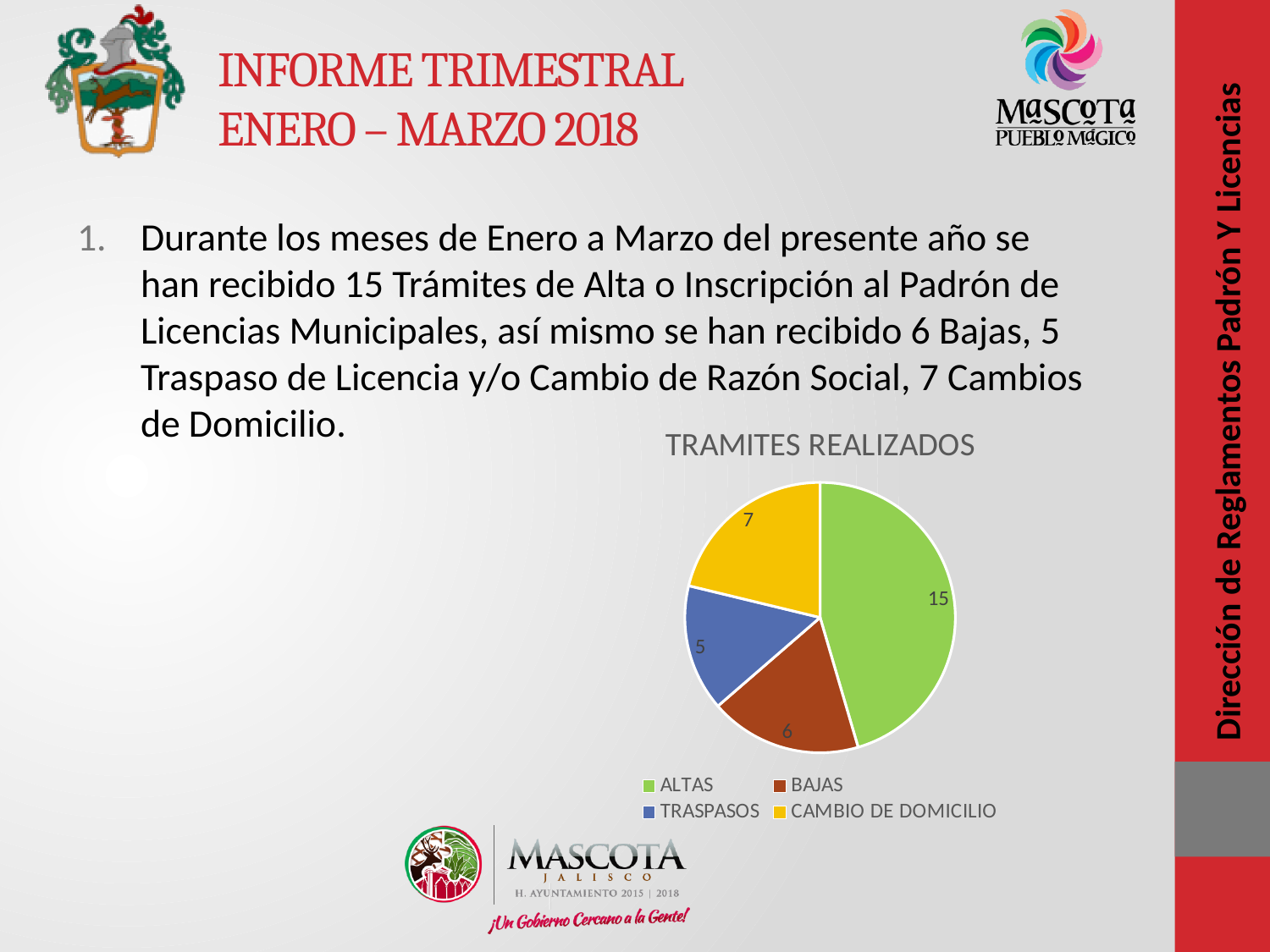
Which category has the smallest slice in the pie chart? TRASPASOS What is the value for TRASPASOS in the pie chart? 5 What is the value for CAMBIO DE DOMICILIO in the pie chart? 7 Which category has the largest slice in the pie chart? ALTAS What is the title of the chart? TRAMITES REALIZADOS What is the value for ALTAS in the pie chart? 15 What is the value for BAJAS in the pie chart? 6 How many categories does the pie chart show? 4 What is the difference between the values for ALTAS and BAJAS? 9 What type of chart is shown on the slide? pie chart What is the total of all slices in the pie chart? 33 Which is larger, CAMBIO DE DOMICILIO or TRASPASOS? CAMBIO DE DOMICILIO